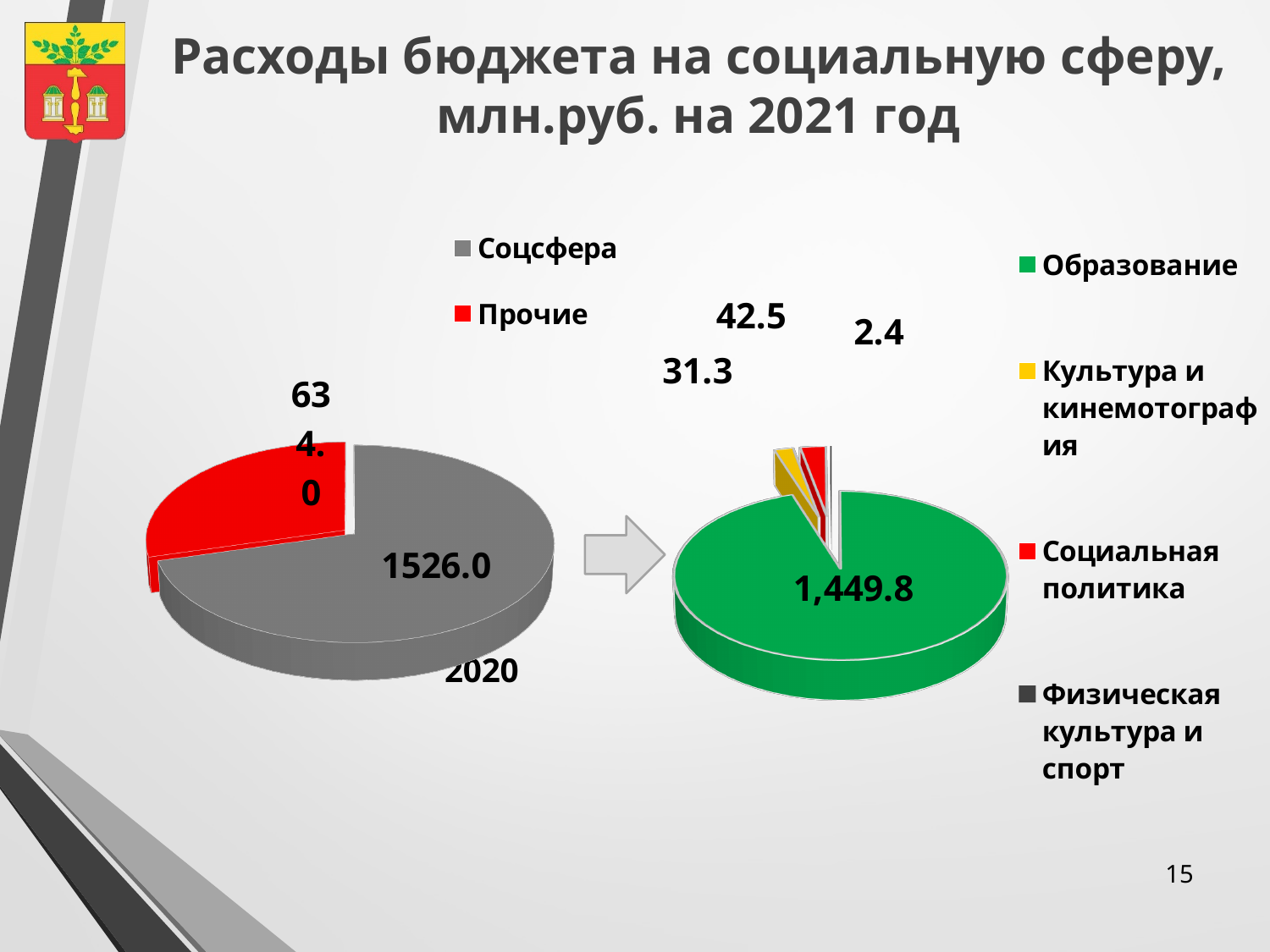
On the left pie chart, what is the value for Соцсфера? 1526.0 On the right pie chart, which category is the smallest? Физическая культура и спорт On the left pie chart, what is the difference between Соцсфера and Прочие? 892.0 On the right pie chart, what colour is the Образование slice? Green On the right pie chart, what is the value for Образование? 1,449.8 On the left pie chart, what is the value for Прочие? 634.0 How many categories does the right pie chart's legend list? 4 What kind of charts are shown on the slide? Pie charts On the left pie chart, which category is the largest? Соцсфера On the right pie chart, which category is the largest? Образование How many slices does the left pie chart have? 2 On the left pie chart, which is larger, Соцсфера or Прочие? Соцсфера